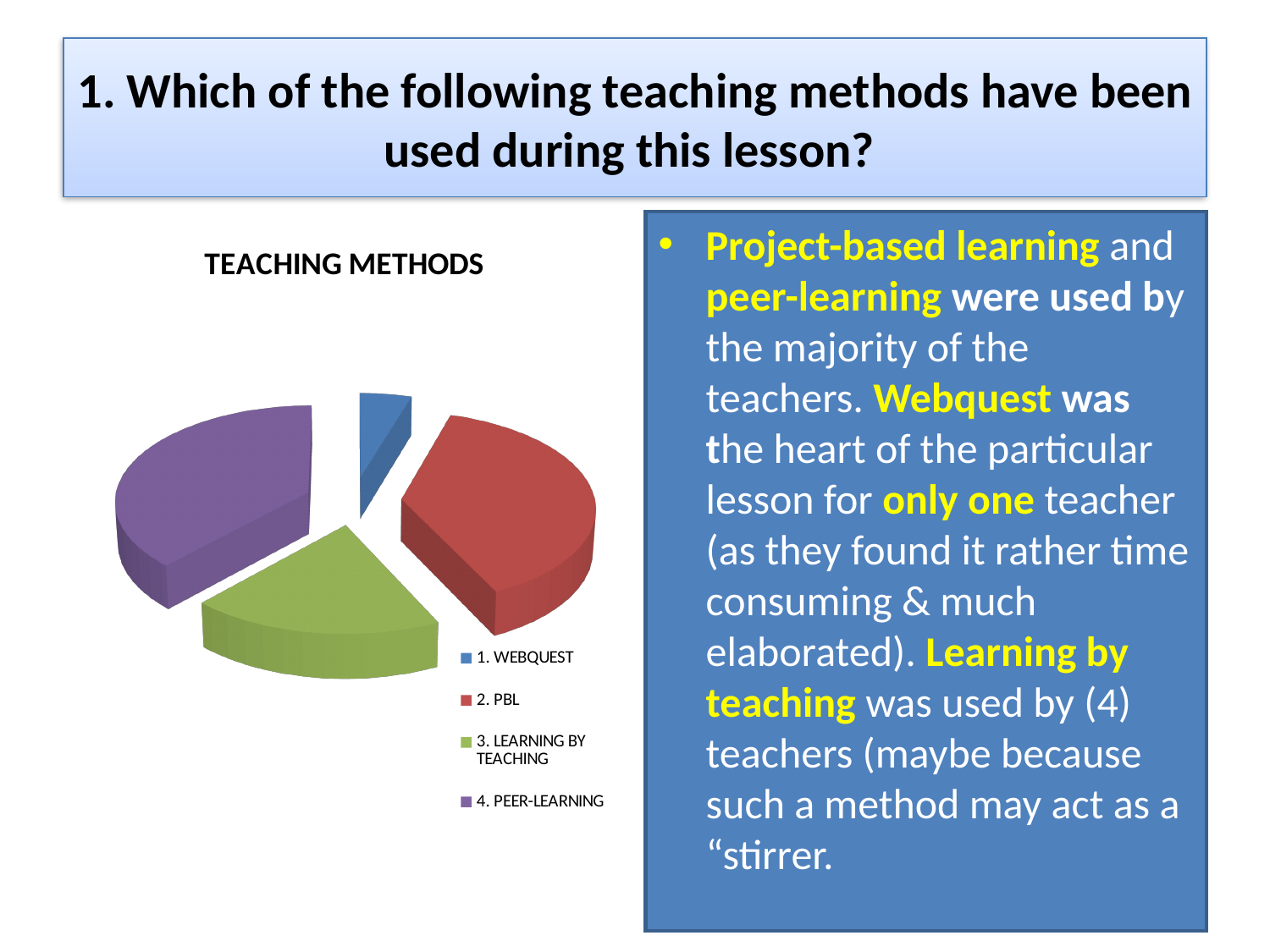
How many entries does the chart legend list? 4 Which slice is larger, 1. WEBQUEST or 3. LEARNING BY TEACHING? 3. LEARNING BY TEACHING What is the title of the chart? TEACHING METHODS Which slice is larger, 1. WEBQUEST or 2. PBL? 2. PBL How many slices does the pie chart have? 4 What colour is the slice for 4. PEER-LEARNING? purple Which slice is larger, 1. WEBQUEST or 4. PEER-LEARNING? 4. PEER-LEARNING What kind of chart is shown on the slide? pie chart Which teaching method has the smallest slice in the pie chart? 1. WEBQUEST